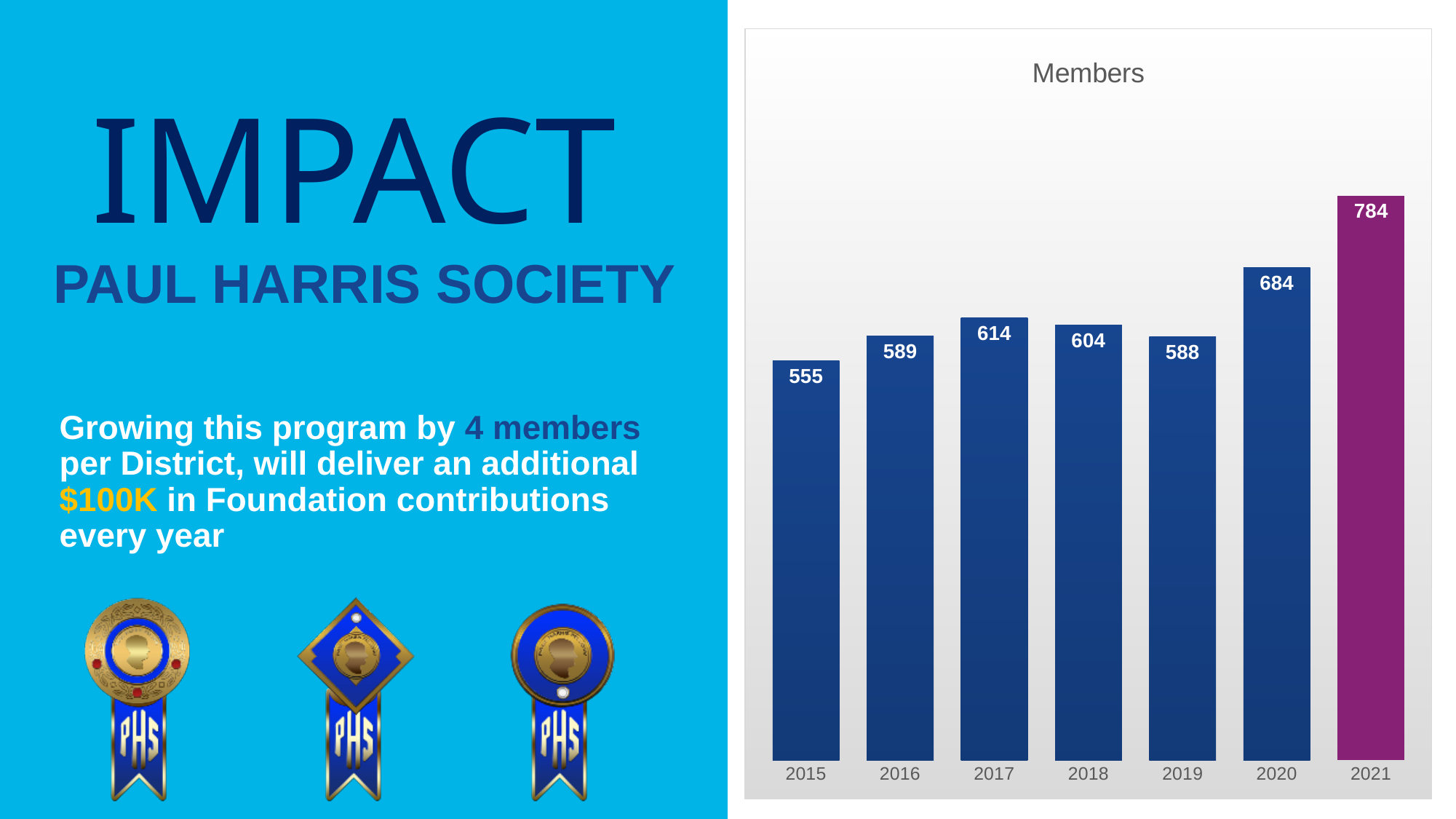
What kind of chart is the Members chart? bar chart What is the title of the chart on the slide? Members How many years are shown in the Members chart? 7 What is the difference in members between 2021 and 2020? 100 What is the value for 2021 in the Members chart? 784 What is the value for 2015 in the Members chart? 555 Which year has the highest number of members? 2021 Which year has the lowest number of members? 2015 What is the value for 2019 in the Members chart? 588 What is the difference in members between 2017 and 2016? 25 Which year has more members, 2018 or 2019? 2018 Do the member values rise or fall from 2019 to 2021? rise